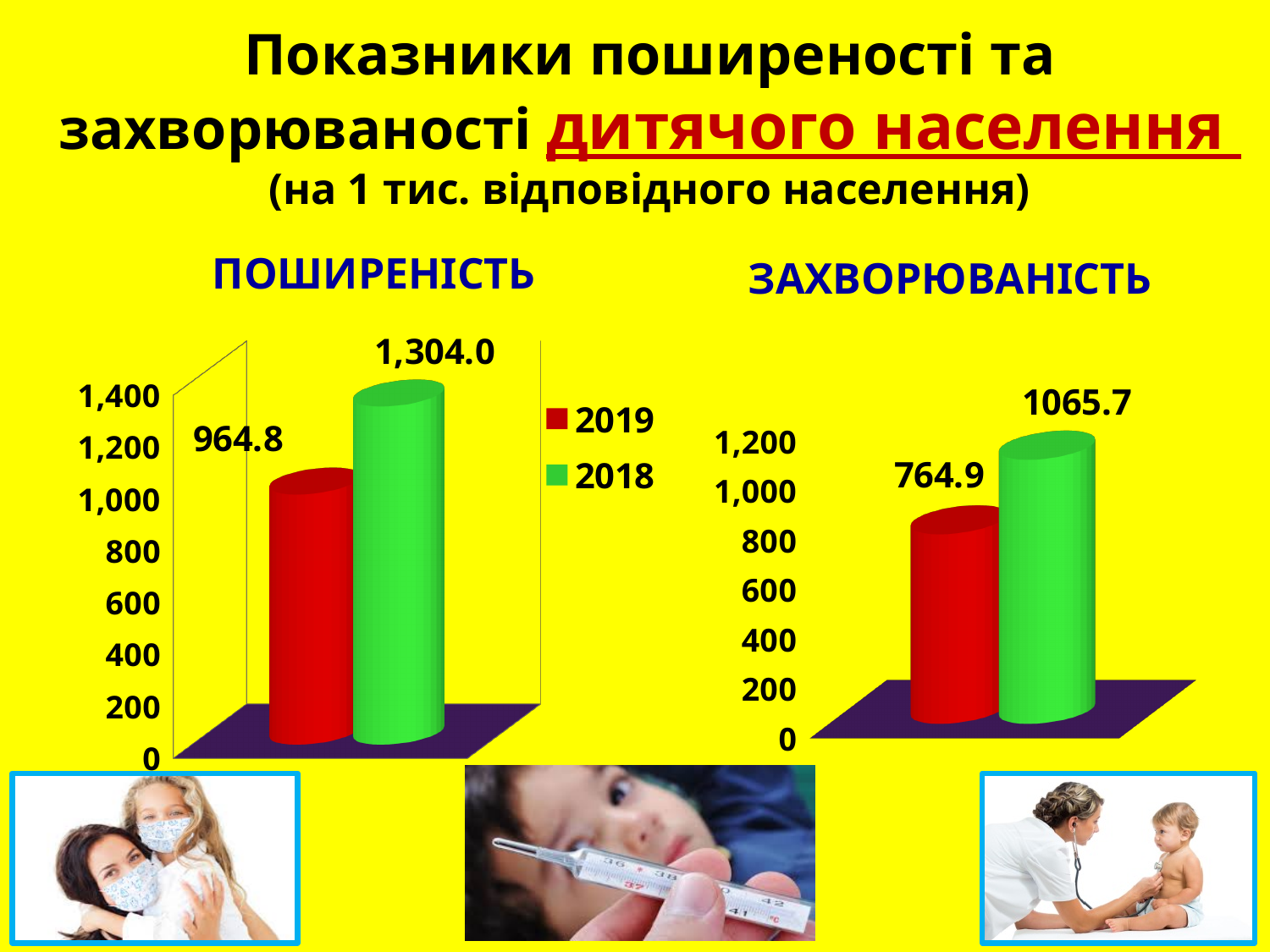
In the legend, which colour represents 2018? Green In the ПОШИРЕНІСТЬ chart, what is the value for 2019? 964.8 In the ЗАХВОРЮВАНІСТЬ chart, what is the difference between the 2018 and 2019 values? 300.8 In the ЗАХВОРЮВАНІСТЬ chart, which year has the lower value? 2019 In the ПОШИРЕНІСТЬ chart, what is the difference between the 2018 and 2019 values? 339.2 In the ЗАХВОРЮВАНІСТЬ chart, what is the value for 2018? 1065.7 In the ПОШИРЕНІСТЬ chart, which year has the higher value? 2018 What kind of chart is the ПОШИРЕНІСТЬ chart? Bar chart In the ЗАХВОРЮВАНІСТЬ chart, is the value for 2019 greater or less than 800? less In the ЗАХВОРЮВАНІСТЬ chart, what is the value for 2019? 764.9 In the ПОШИРЕНІСТЬ chart, what is the value for 2018? 1,304.0 How many series does the legend on the slide list? 2